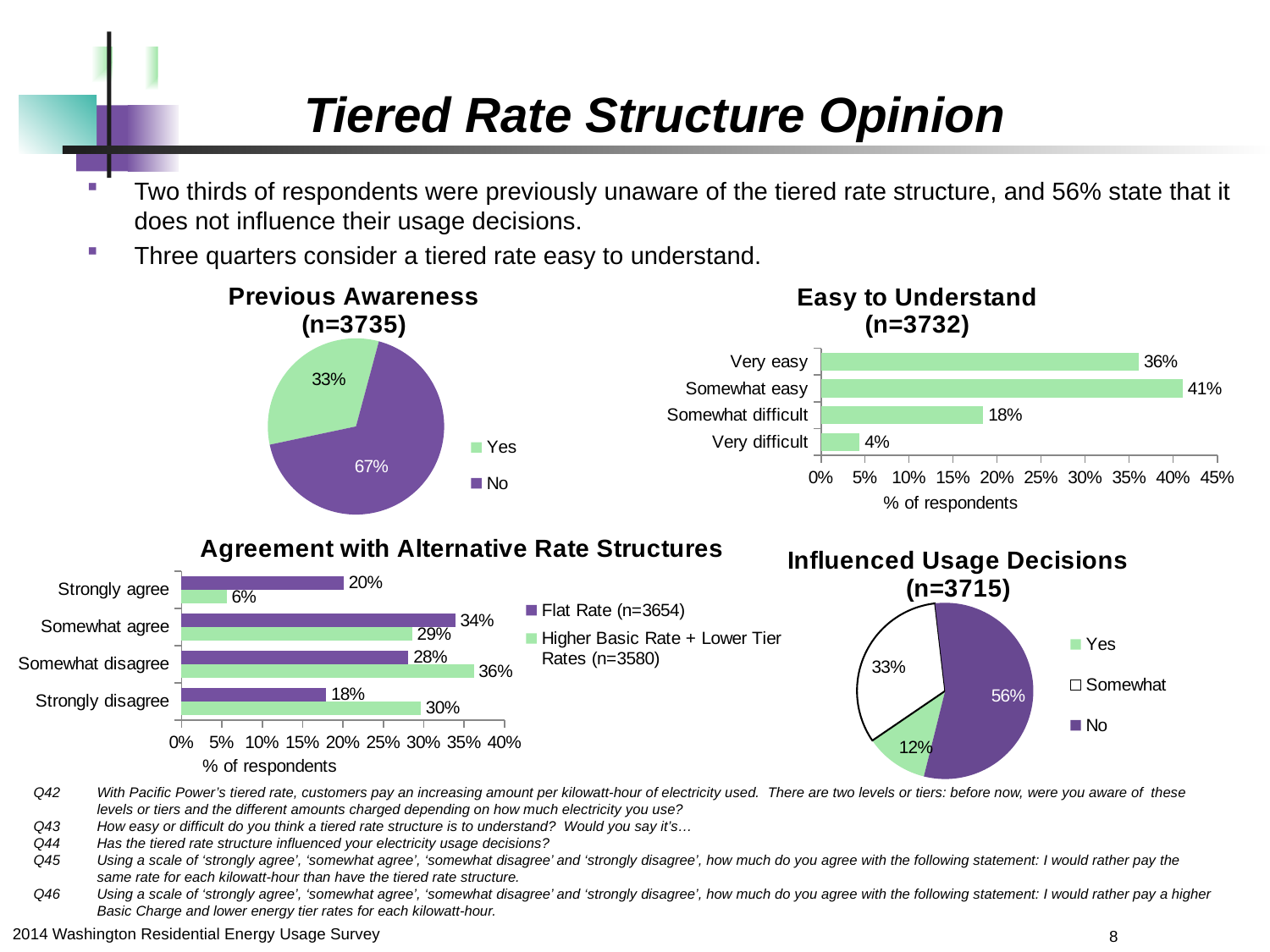
In the Previous Awareness pie chart, what share of respondents answered Yes? 33% In the Easy to Understand chart, which category has the lowest value? Very difficult In the Easy to Understand chart, what is the value for Somewhat easy? 41% In the Previous Awareness pie chart, what share of respondents answered No? 67% In the Agreement with Alternative Rate Structures chart, what is the Flat Rate value for Somewhat agree? 34% In the Influenced Usage Decisions pie chart, which response has the largest share? No In the Agreement with Alternative Rate Structures chart, how many series does the legend list? 2 In the Easy to Understand chart, how many categories are shown? 4 In the Influenced Usage Decisions pie chart, what share of respondents answered Somewhat? 33% In the Agreement with Alternative Rate Structures chart, which series has the larger value for Strongly disagree, Flat Rate or Higher Basic Rate + Lower Tier Rates? Higher Basic Rate + Lower Tier Rates In the Easy to Understand chart, what is the difference between Very easy and Somewhat difficult? 18% What kind of chart is the Agreement with Alternative Rate Structures chart? Bar chart